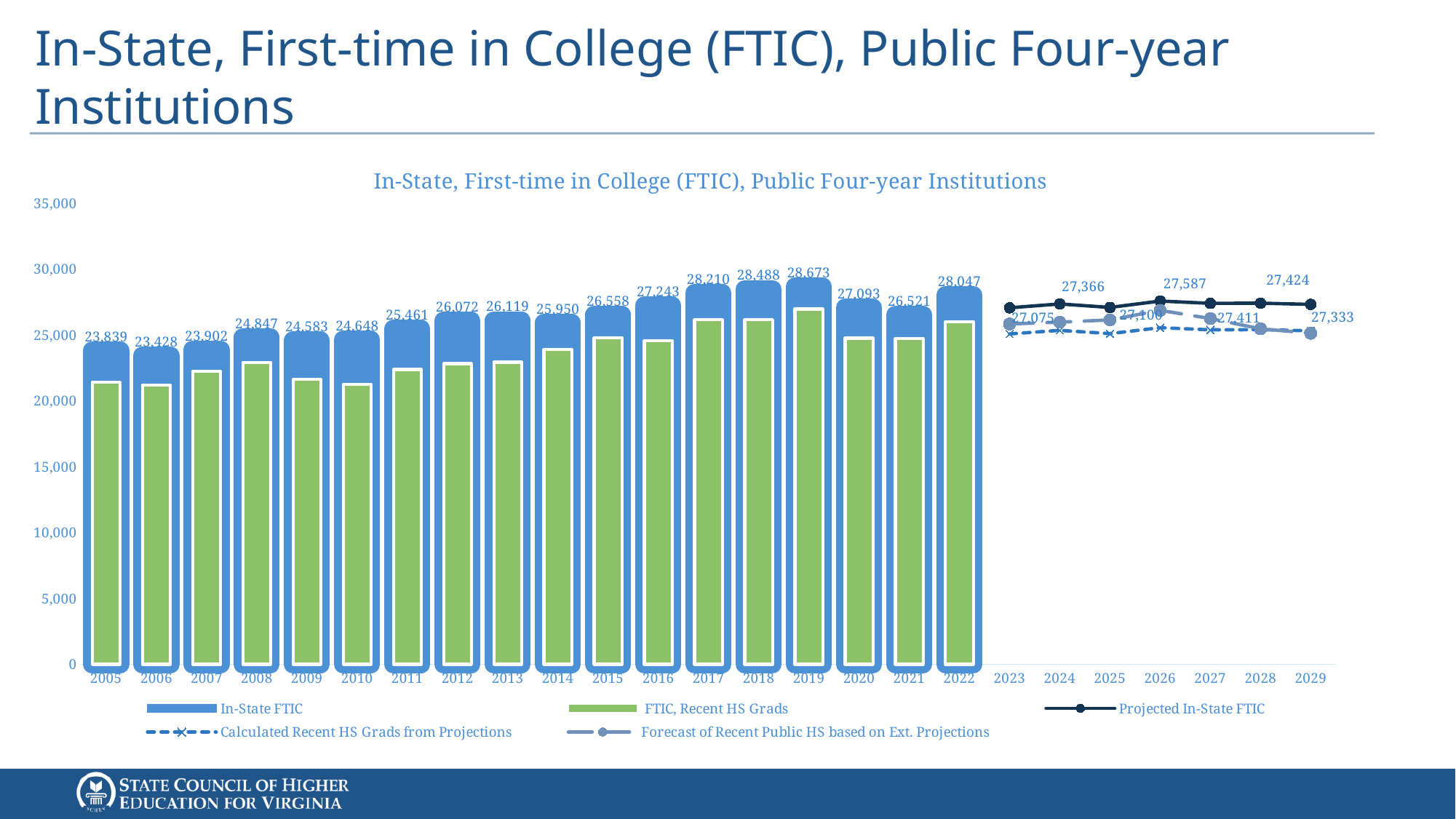
Do the In-State FTIC values rise or fall from 2016 to 2019? rise What is the difference between the In-State FTIC values for 2022 and 2021? 1,526 Is the FTIC, Recent HS Grads value for 2005 greater or less than 25,000? less How many series does the legend list? 5 Which year has the lowest In-State FTIC bar? 2006 What is the Projected In-State FTIC value for 2026? 27,587 Which year has the highest In-State FTIC bar? 2019 What is the In-State FTIC value for 2012? 26,072 How many years are shown with In-State FTIC bars? 18 What kind of chart is used to show the In-State FTIC values from 2005 to 2022? bar chart What is the In-State FTIC value for 2019? 28,673 Which year has a larger In-State FTIC value, 2017 or 2018? 2018